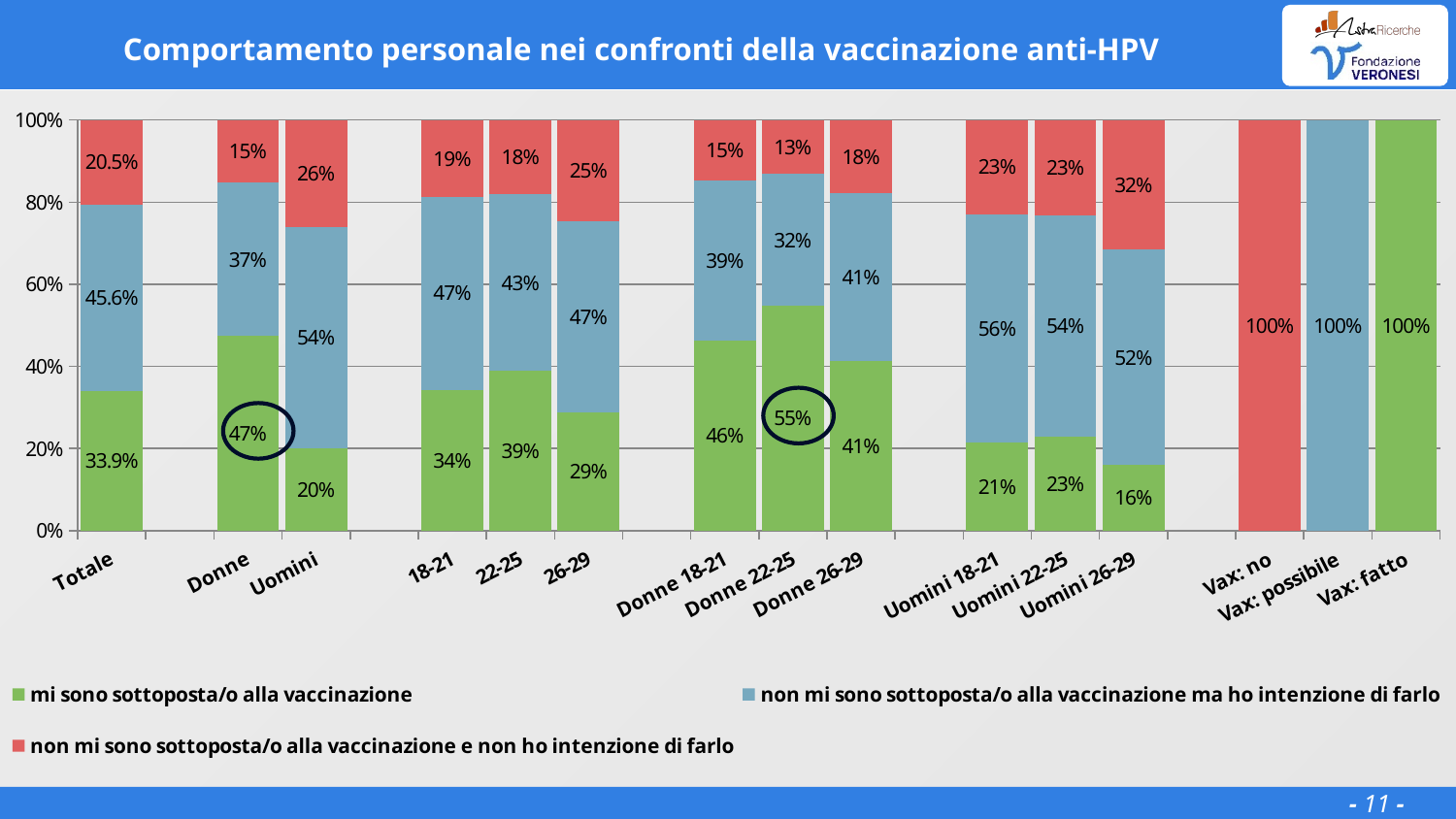
What is the difference between the 'mi sono sottoposta/o alla vaccinazione' values for Donne and Uomini? 27% What kind of chart is shown on the slide? stacked bar chart Among Uomini 18-21, Uomini 22-25 and Uomini 26-29, which has the lowest value for 'mi sono sottoposta/o alla vaccinazione'? Uomini 26-29 How many series does the legend list? 3 Which is larger: the 'non mi sono sottoposta/o alla vaccinazione e non ho intenzione di farlo' value for 26-29 or for 22-25? 26-29 What is the value of 'mi sono sottoposta/o alla vaccinazione' for Totale? 33.9% What is the title of the chart? Comportamento personale nei confronti della vaccinazione anti-HPV How many categories are shown on the x axis? 15 What is the value of 'non mi sono sottoposta/o alla vaccinazione e non ho intenzione di farlo' for Uomini 26-29? 32% What is the value of 'mi sono sottoposta/o alla vaccinazione' for Donne 22-25? 55% Among Donne 18-21, Donne 22-25 and Donne 26-29, which has the highest value for 'mi sono sottoposta/o alla vaccinazione'? Donne 22-25 What is the value of 'non mi sono sottoposta/o alla vaccinazione ma ho intenzione di farlo' for Uomini? 54%